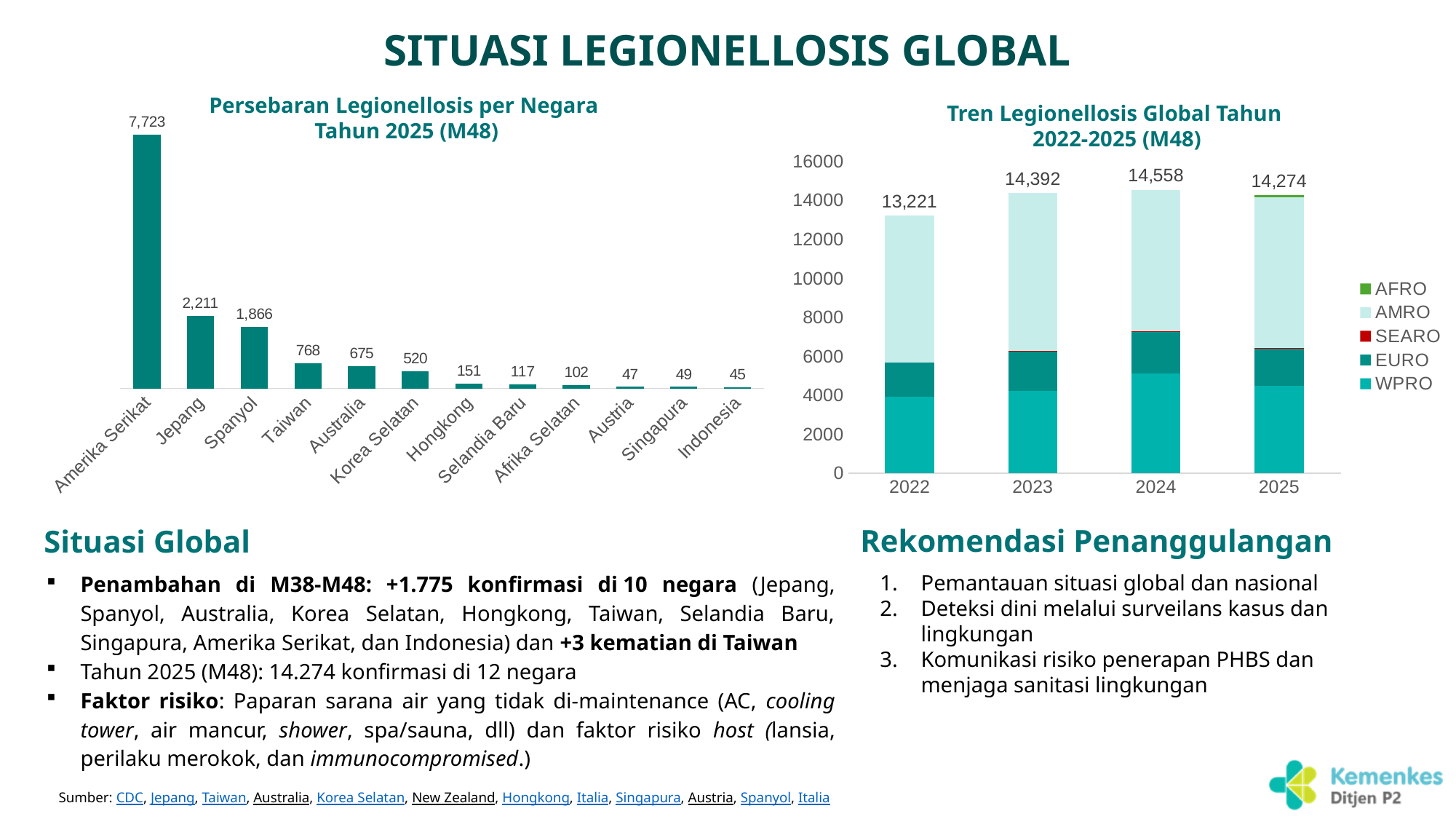
How many series does the legend of the chart 'Tren Legionellosis Global Tahun 2022-2025 (M48)' list? 5 In the chart 'Tren Legionellosis Global Tahun 2022-2025 (M48)', which year has the lowest total? 2022 What kind of chart is 'Persebaran Legionellosis per Negara Tahun 2025 (M48)'? Bar chart In the chart 'Persebaran Legionellosis per Negara Tahun 2025 (M48)', which country has the lowest value? Indonesia In the chart 'Tren Legionellosis Global Tahun 2022-2025 (M48)', what is the difference between the totals for 2023 and 2022? 1,171 In the chart 'Tren Legionellosis Global Tahun 2022-2025 (M48)', what is the total for 2024? 14,558 In the chart 'Persebaran Legionellosis per Negara Tahun 2025 (M48)', which is larger, the value for Hongkong or the value for Selandia Baru? Hongkong In the chart 'Persebaran Legionellosis per Negara Tahun 2025 (M48)', what is the difference between the values for Taiwan and Australia? 93 In the chart 'Persebaran Legionellosis per Negara Tahun 2025 (M48)', what is the value for Jepang? 2,211 How many countries are shown in the chart 'Persebaran Legionellosis per Negara Tahun 2025 (M48)'? 12 In the chart 'Persebaran Legionellosis per Negara Tahun 2025 (M48)', which country has the highest value? Amerika Serikat